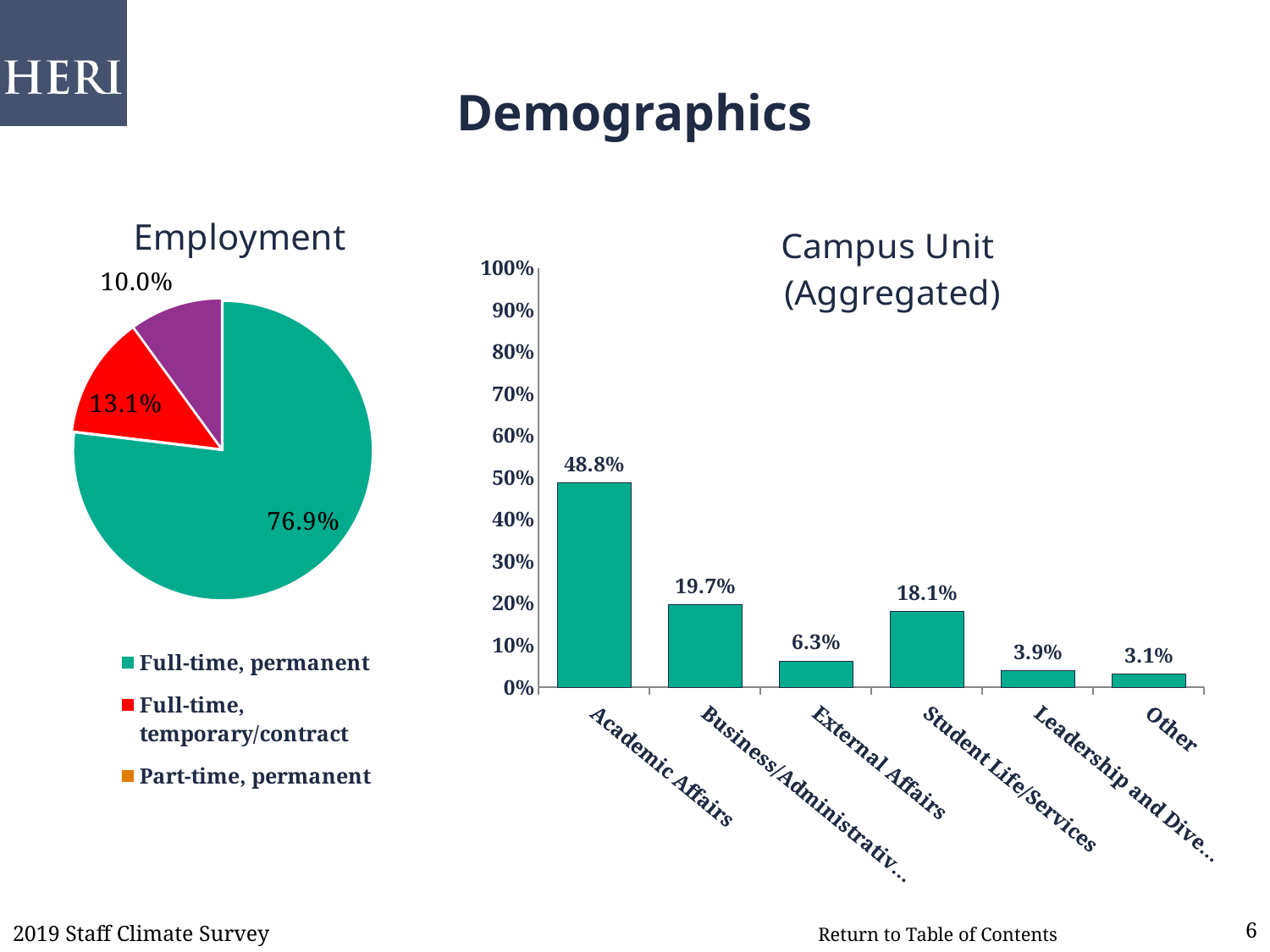
In the Employment pie chart, what share is Full-time, permanent? 76.9% In the Campus Unit (Aggregated) chart, what is the difference between Academic Affairs and External Affairs? 42.5% In the Campus Unit (Aggregated) chart, what is the value for Student Life/Services? 18.1% In the Campus Unit (Aggregated) chart, how many categories are shown? 6 In the Employment pie chart, what share is Full-time, temporary/contract? 13.1% In the Employment pie chart, which category has the largest slice? Full-time, permanent In the Campus Unit (Aggregated) chart, what is the value for Academic Affairs? 48.8% In the Campus Unit (Aggregated) chart, what is the value for Other? 3.1% What kind of chart is the Employment chart? Pie chart In the Campus Unit (Aggregated) chart, which category has the lowest value? Other In the Employment pie chart, how many entries does the legend list? 3